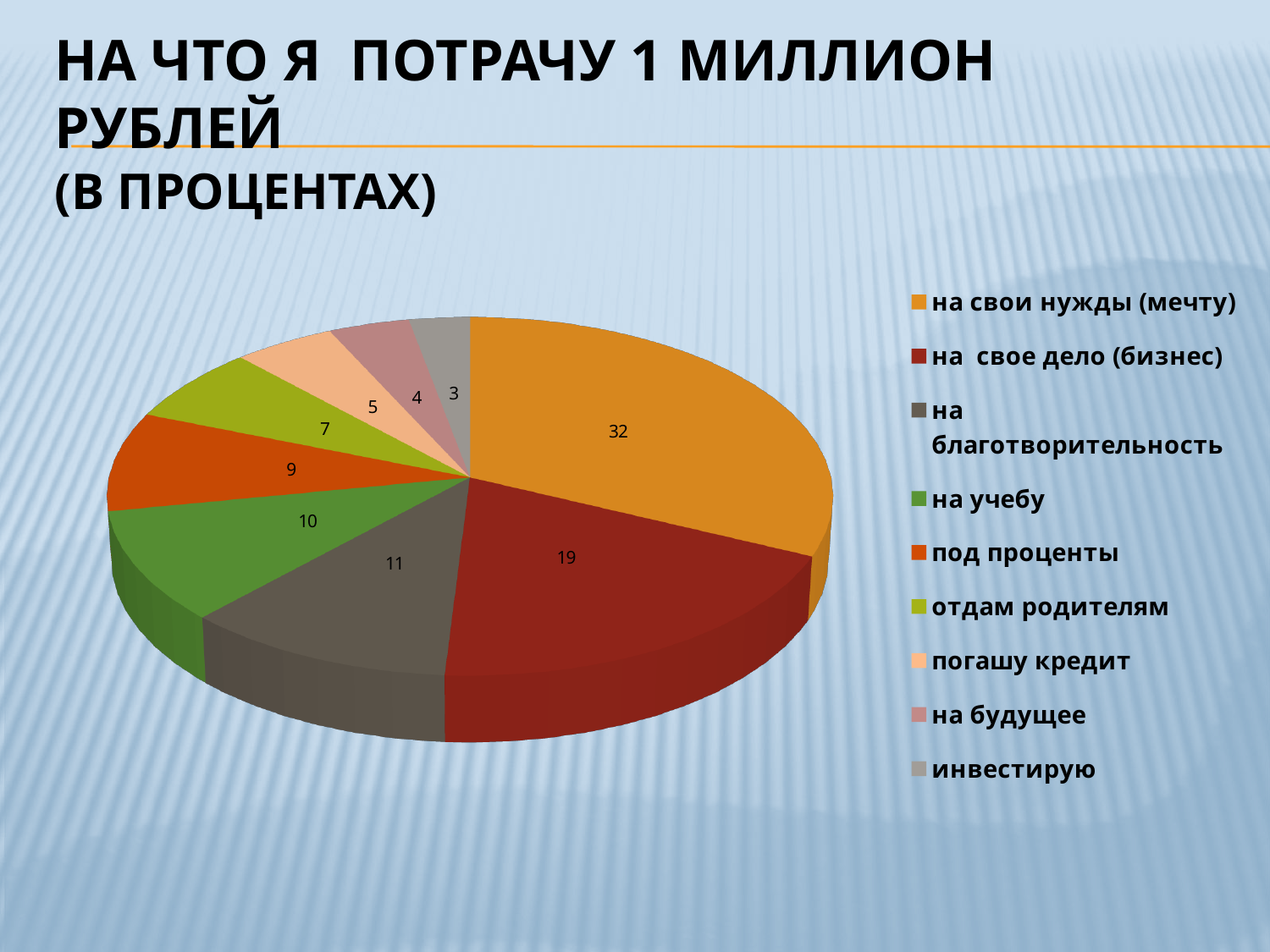
What is the difference between the values for "на свои нужды (мечту)" and "на свое дело (бизнес)"? 13 What value is shown for the slice "на свои нужды (мечту)"? 32 What colour is the slice for "на свое дело (бизнес)"? dark red Which is larger, the value for "на благотворительность" or the value for "под проценты"? на благотворительность What value is shown for the slice "погашу кредит"? 5 What is the difference between the values for "отдам родителям" and "на будущее"? 3 Which category has the smallest slice of the pie? инвестирую Which category has the largest slice of the pie? на свои нужды (мечту) What kind of chart is shown on the slide? pie chart What value is shown for the slice "на свое дело (бизнес)"? 19 How many slices does the pie chart have? 9 What value is shown for the slice "на учебу"? 10